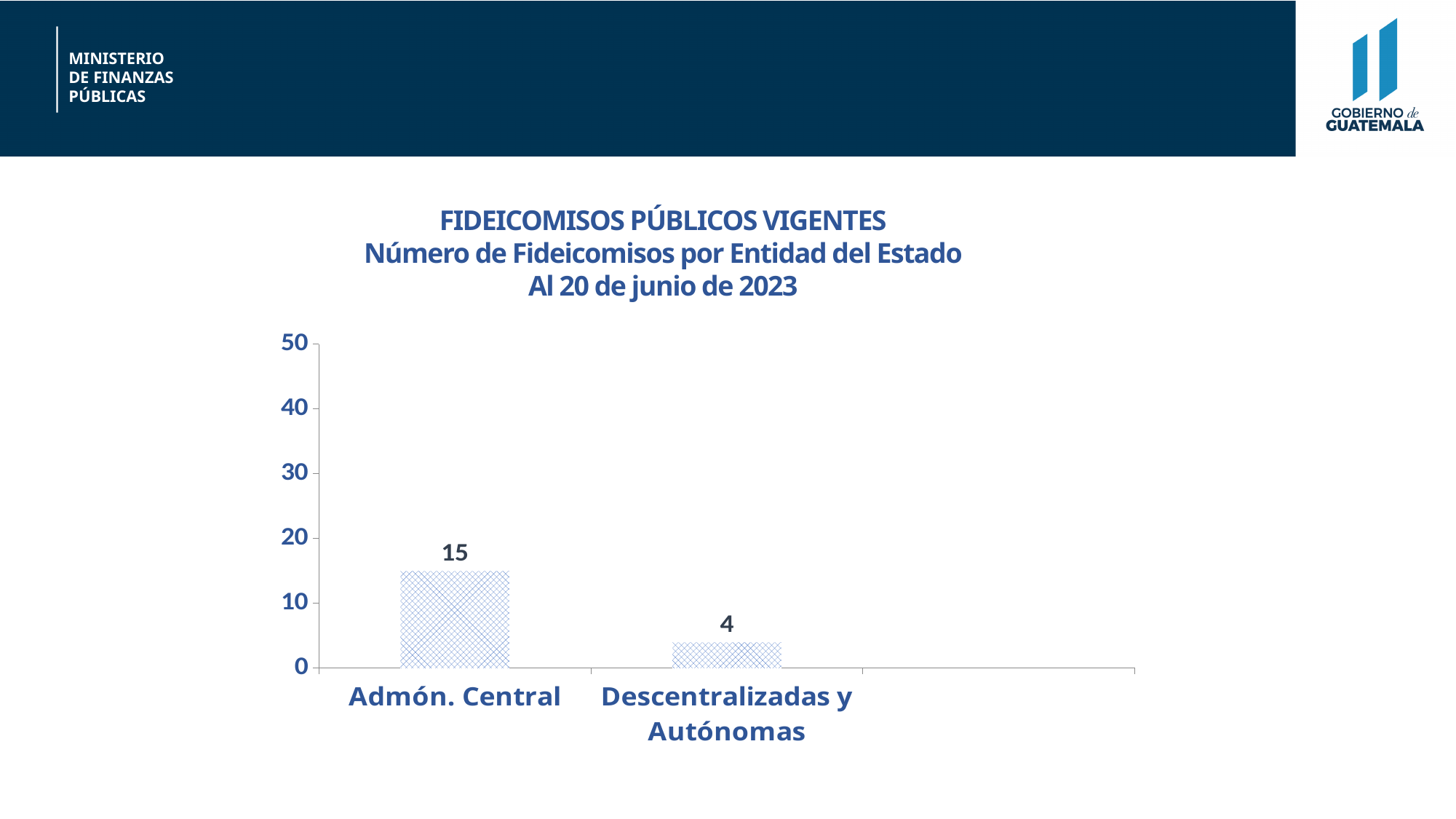
What kind of chart is shown on the slide? bar chart How many categories are shown on the x axis? 2 What is the value for Descentralizadas y Autónomas? 4 Which category has the lowest value? Descentralizadas y Autónomas Is the value for Admón. Central greater or less than 20? less What is the maximum value shown on the y axis? 50 What date does the chart title say the data is as of? 20 de junio de 2023 What is the value for Admón. Central? 15 Which is larger, the value for Admón. Central or the value for Descentralizadas y Autónomas? Admón. Central Which category has the highest value? Admón. Central Is the value for Descentralizadas y Autónomas greater or less than 10? less What is the difference between the values for Admón. Central and Descentralizadas y Autónomas? 11